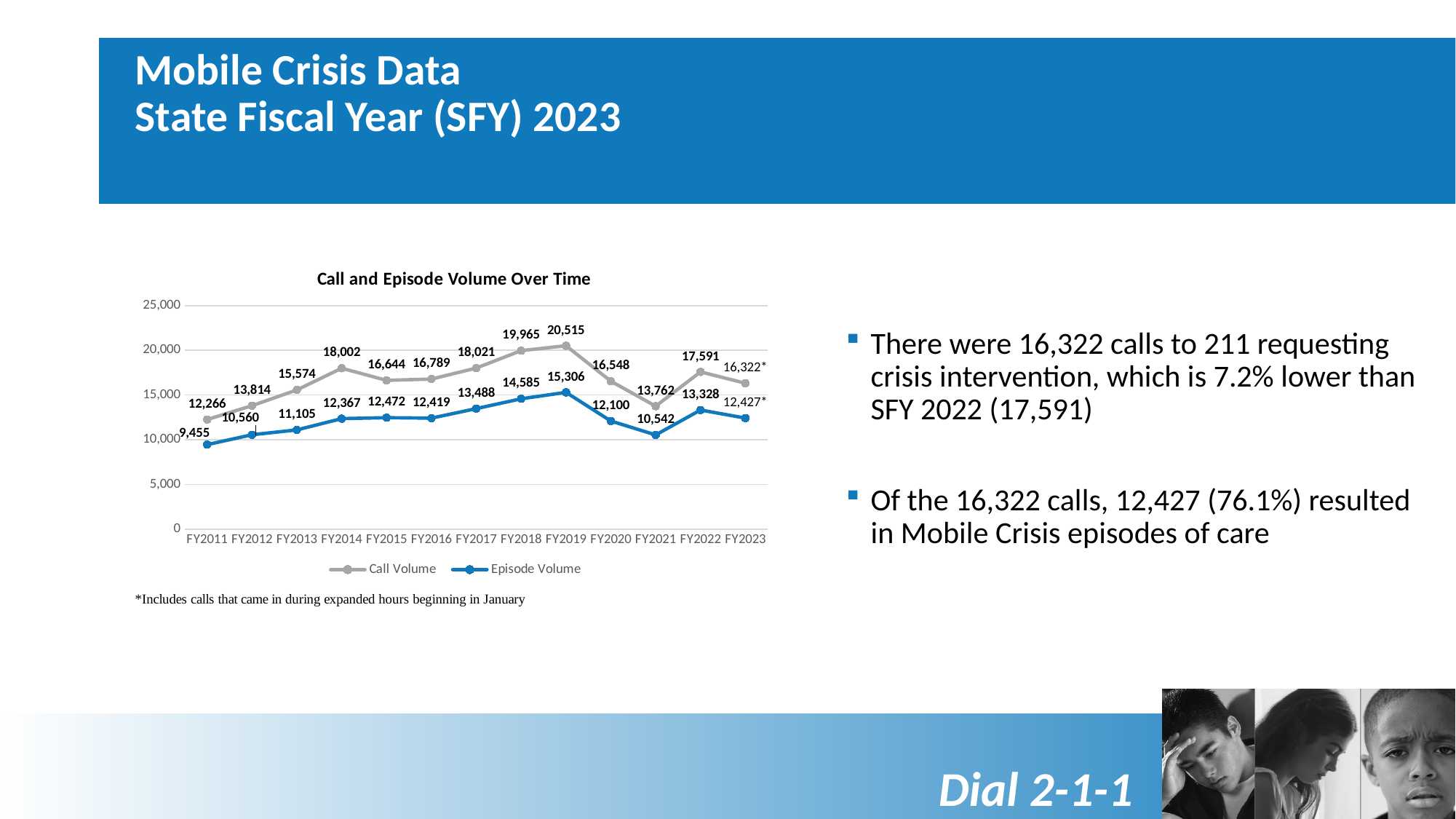
How many fiscal years are plotted on the x axis? 13 In which fiscal year is the Episode Volume lowest? FY2011 Does the Episode Volume rise or fall from FY2011 to FY2014? Rise What type of chart is shown on the slide? Line chart What is the title of the chart? Call and Episode Volume Over Time In which fiscal year is the Call Volume highest? FY2019 What is the Call Volume for FY2019? 20,515 What is the difference between the Call Volume and the Episode Volume in FY2023? 3,895 Which is larger, the Call Volume in FY2022 or the Call Volume in FY2023? FY2022 How many series does the legend list? 2 Is the Episode Volume for FY2019 greater or less than 15,000? greater What is the Episode Volume for FY2021? 10,542